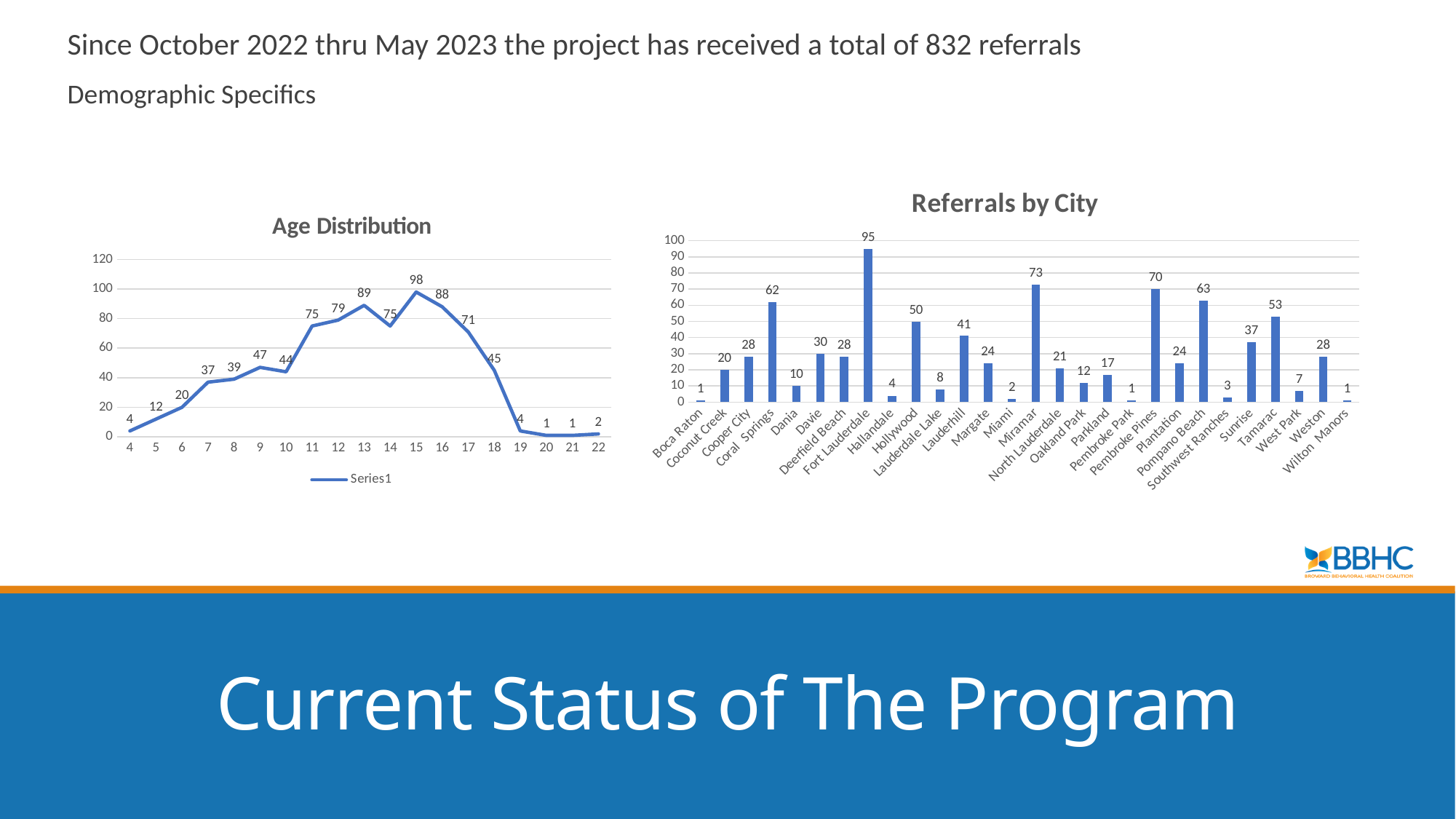
In the Referrals by City chart, what is the difference between the referrals for Coral Springs and Tamarac? 9 In the Referrals by City chart, how many cities are shown? 28 In the Age Distribution chart, which age has the highest value? 15 In the Referrals by City chart, which has more referrals, Miramar or Pembroke Pines? Miramar In the Age Distribution chart, what is the value at age 15? 98 In the Age Distribution chart, do the values rise or fall from age 15 to age 22? fall In the Referrals by City chart, which city has the most referrals? Fort Lauderdale In the Age Distribution chart, what is the difference between the values at age 13 and age 14? 14 In the Age Distribution chart, what kind of chart is shown? line chart In the Referrals by City chart, how many referrals came from Fort Lauderdale? 95 In the Referrals by City chart, what kind of chart is shown? bar chart In the Age Distribution chart, how many ages are plotted on the x axis? 19